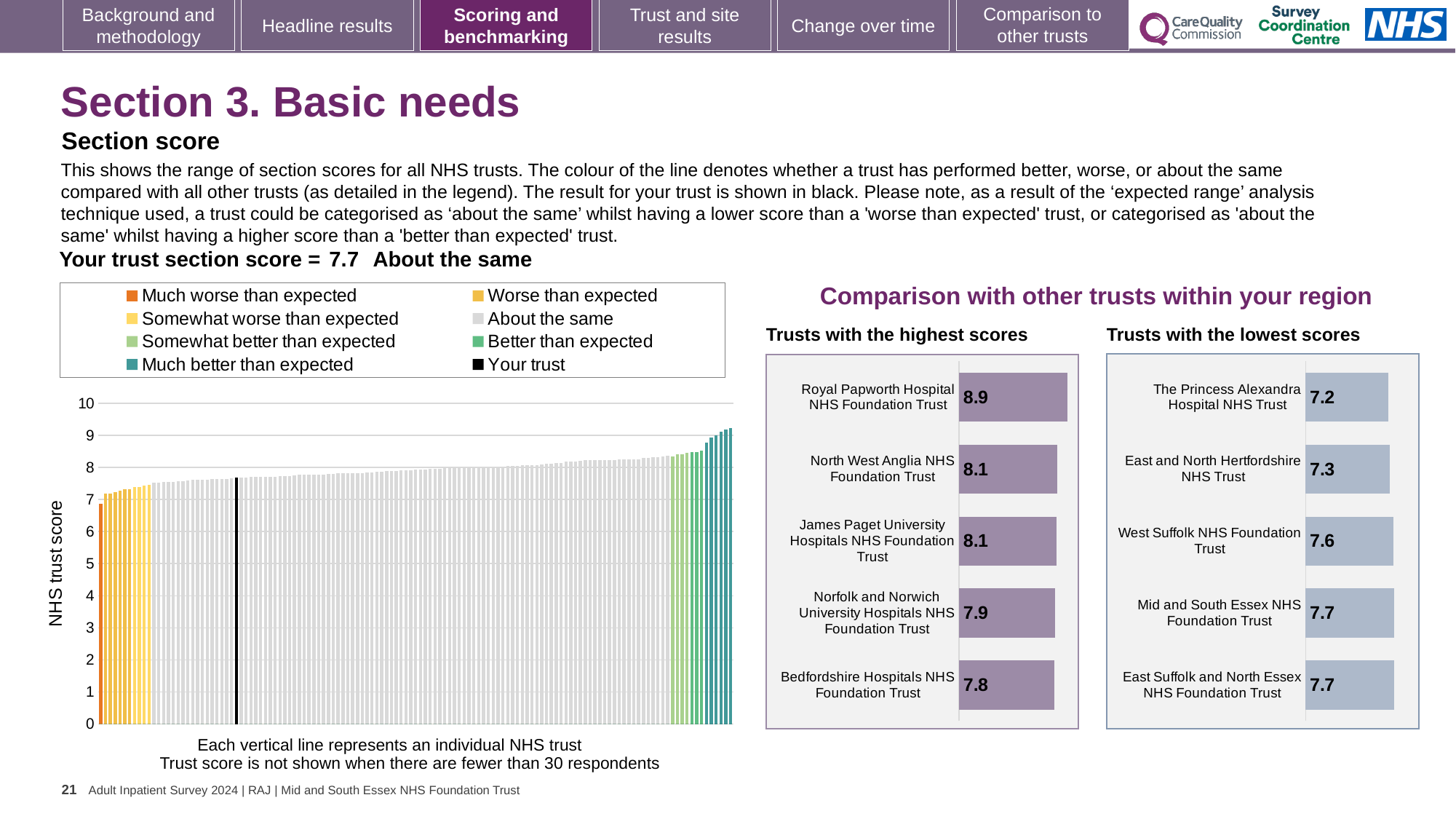
In the large chart on the left showing NHS trust scores, what is the section score for your trust? 7.7 In the 'Trusts with the highest scores' chart, what is the difference between the scores of Royal Papworth Hospital NHS Foundation Trust and Bedfordshire Hospitals NHS Foundation Trust? 1.1 In the 'Trusts with the highest scores' chart, which trust has the highest score? Royal Papworth Hospital NHS Foundation Trust In the 'Trusts with the lowest scores' chart, which trust has the lowest score? The Princess Alexandra Hospital NHS Trust In the 'Trusts with the highest scores' chart, what is the score for Royal Papworth Hospital NHS Foundation Trust? 8.9 In the 'Trusts with the lowest scores' chart, which has the larger score: West Suffolk NHS Foundation Trust or East and North Hertfordshire NHS Trust? West Suffolk NHS Foundation Trust In the large chart on the left, do the trust scores rise or fall from left to right? rise In the 'Trusts with the lowest scores' chart, what is the score for The Princess Alexandra Hospital NHS Trust? 7.2 In the 'Trusts with the lowest scores' chart, what is the difference between the scores of Mid and South Essex NHS Foundation Trust and The Princess Alexandra Hospital NHS Trust? 0.5 What kind of chart is the large chart on the left showing NHS trust scores? bar chart How many entries does the legend of the large chart on the left list? 8 In the 'Trusts with the highest scores' chart, how many trusts are shown? 5